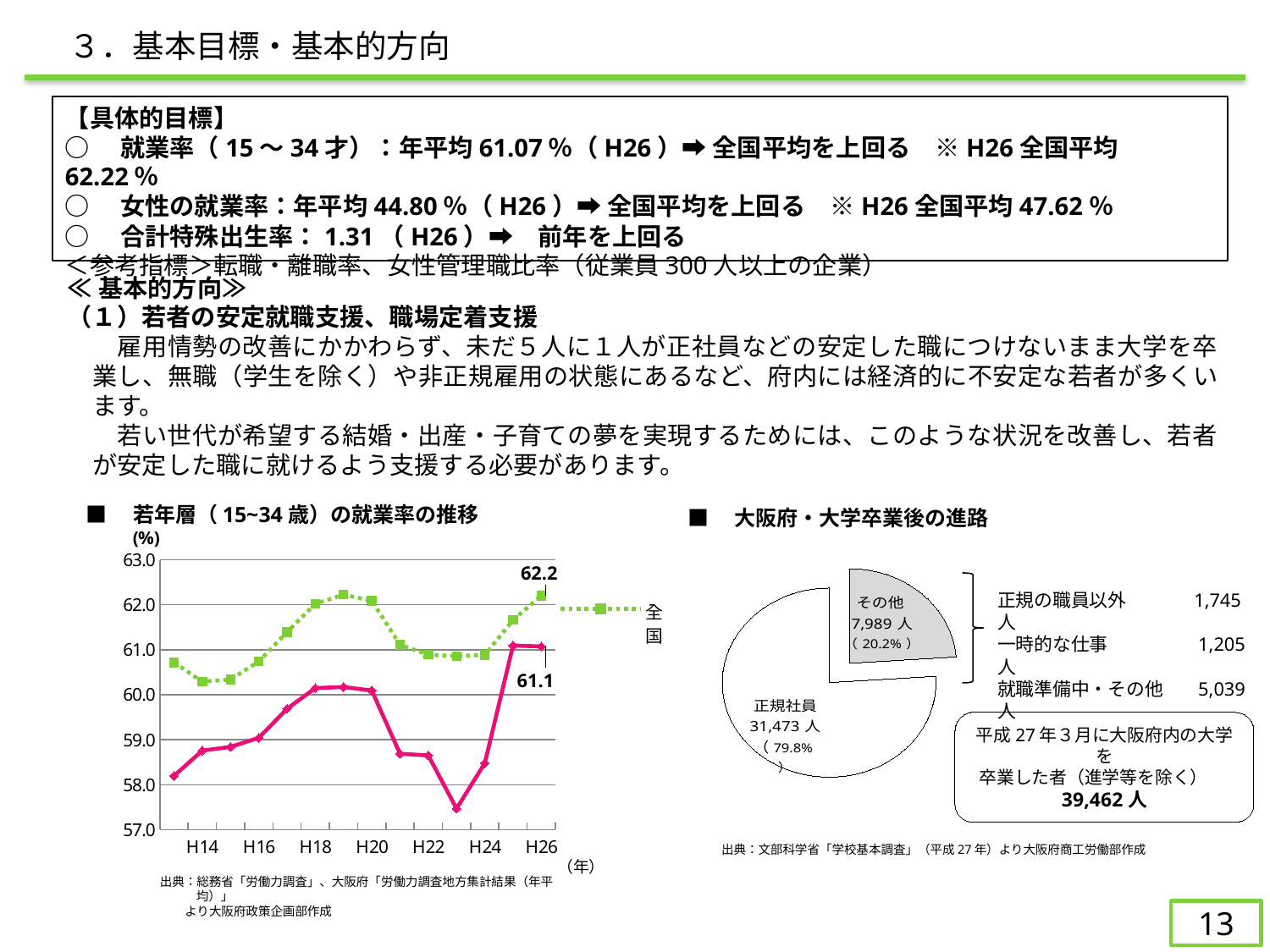
In the pie chart 大阪府・大学卒業後の進路, which slice is larger: 正規社員 or その他? 正規社員 In the line chart 若年層（15~34歳）の就業率の推移, how many years are plotted from H14 to H26? 13 In the pie chart 大阪府・大学卒業後の進路, what is the total number of graduates shown? 39,462人 In the pie chart 大阪府・大学卒業後の進路, how many people are in the その他 slice? 7,989人 In the line chart 若年層（15~34歳）の就業率の推移, what is the difference between the 全国 value and the pink line value at H26? 1.1 In the line chart 若年層（15~34歳）の就業率の推移, is the value of the pink line at H23 greater or less than 58.0? less In the line chart 若年層（15~34歳）の就業率の推移, is the value of the 全国 series at H14 greater or less than 60.0? greater In the line chart 若年層（15~34歳）の就業率の推移, what is the value of the solid pink line at H26? 61.1 In the line chart 若年層（15~34歳）の就業率の推移, which is larger at H26: the 全国 series or the pink line? 全国 In the line chart 若年層（15~34歳）の就業率の推移, what is the value of the 全国 series at H26? 62.2 In the pie chart 大阪府・大学卒業後の進路, what share does 正規社員 represent? 79.8% What kind of chart is 若年層（15~34歳）の就業率の推移? line chart